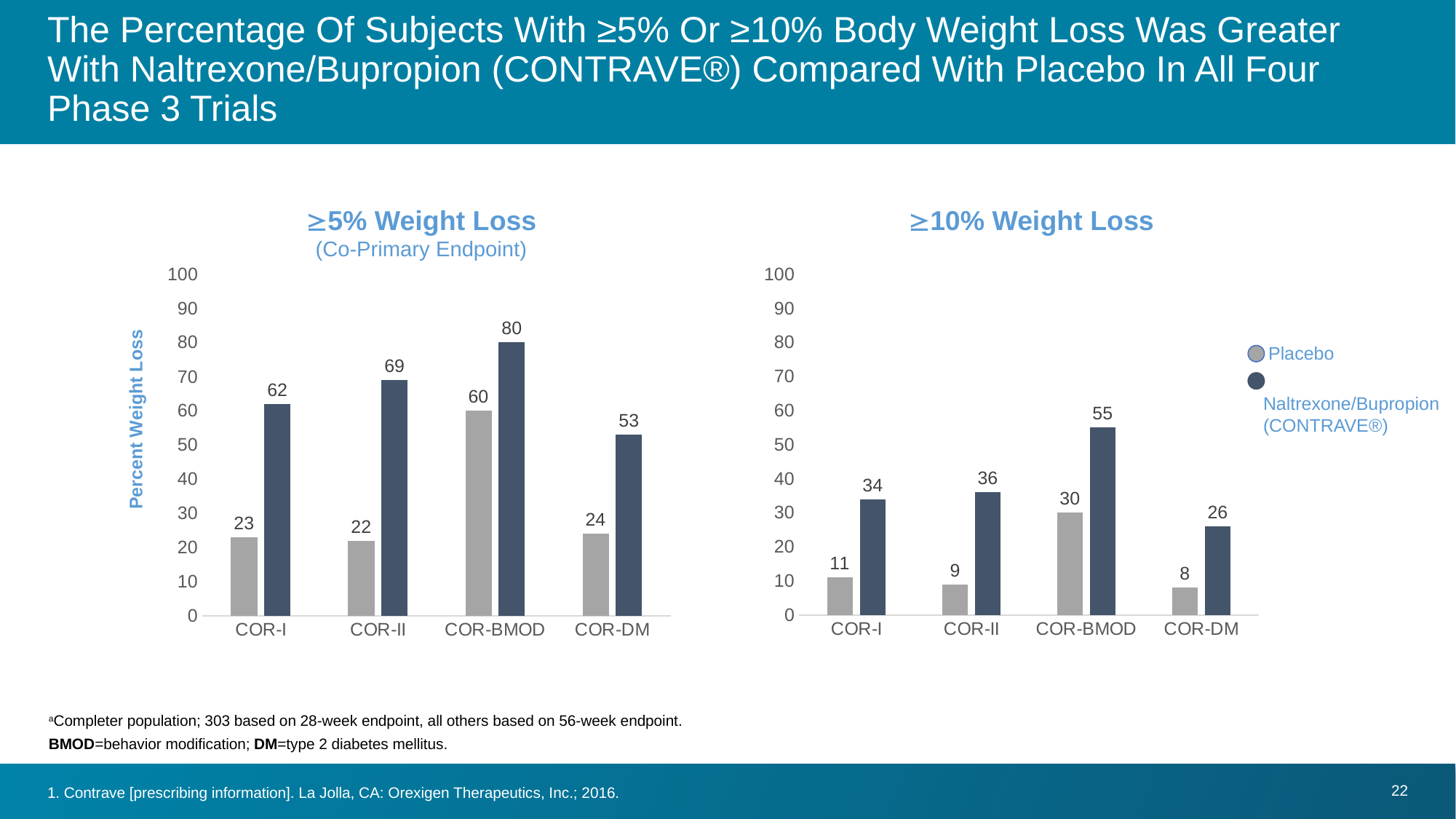
In the ≥10% Weight Loss chart, what is the Placebo value for COR-DM? 8 In the ≥10% Weight Loss chart, what is the difference between the Naltrexone/Bupropion (CONTRAVE®) and Placebo values for COR-BMOD? 25 How many trials are shown on the x axis of the ≥5% Weight Loss chart? 4 In the ≥10% Weight Loss chart, what is the value for Naltrexone/Bupropion (CONTRAVE®) in COR-II? 36 How many series does the legend list? 2 In the ≥5% Weight Loss chart, what is the Placebo value for COR-II? 22 In the ≥10% Weight Loss chart, which is larger: the Naltrexone/Bupropion (CONTRAVE®) value for COR-I or for COR-II? COR-II What type of chart is the ≥10% Weight Loss chart? Bar chart In the ≥5% Weight Loss chart, what is the difference between the Naltrexone/Bupropion (CONTRAVE®) and Placebo values for COR-I? 39 In the ≥5% Weight Loss chart, which trial has the highest Naltrexone/Bupropion (CONTRAVE®) value? COR-BMOD In the ≥10% Weight Loss chart, which trial has the lowest Placebo value? COR-DM In the ≥5% Weight Loss chart, what is the value for Naltrexone/Bupropion (CONTRAVE®) in COR-BMOD? 80